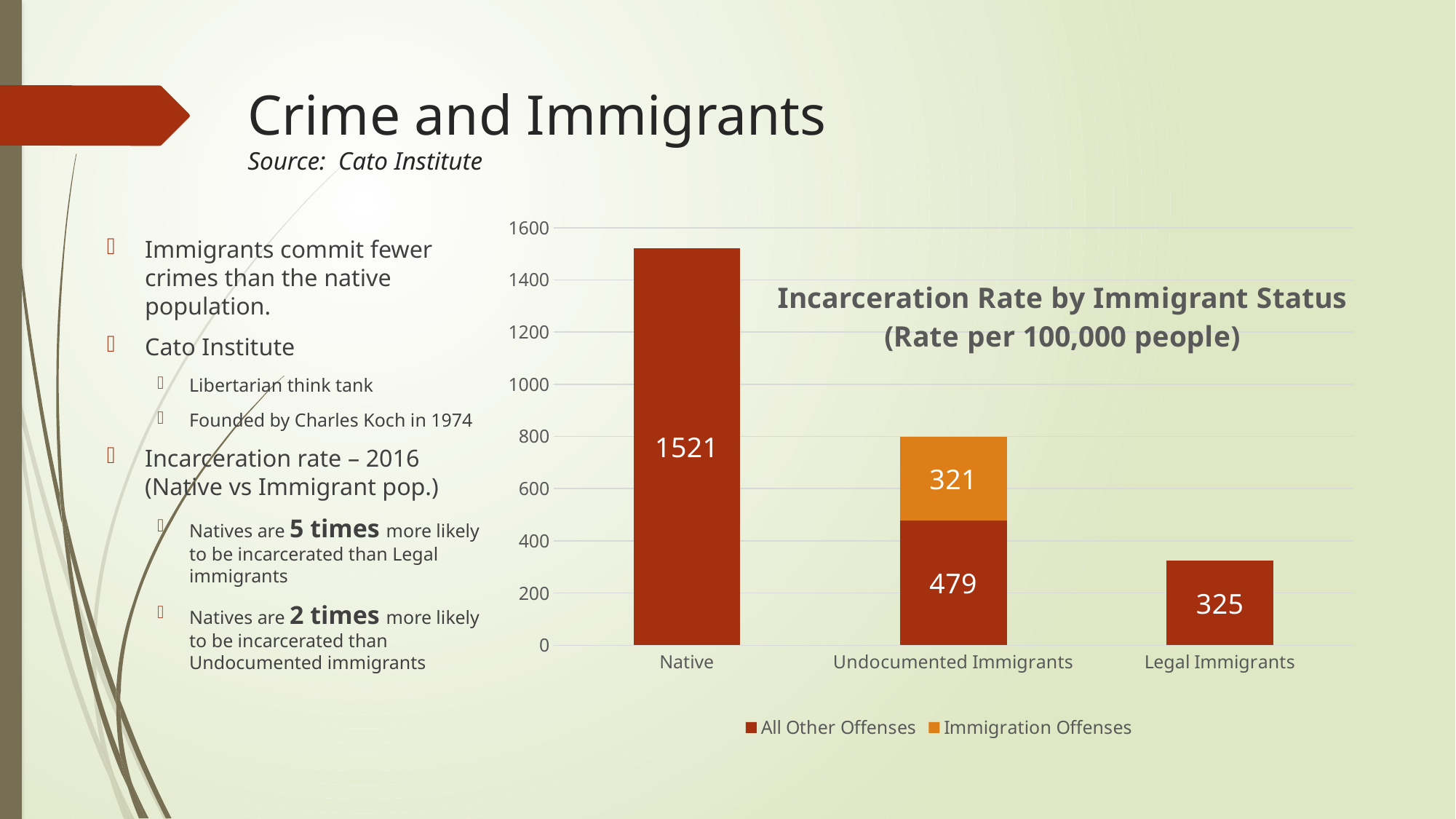
What is the All Other Offenses incarceration rate for Undocumented Immigrants? 479 Which category has the lowest total incarceration rate? Legal Immigrants What is the All Other Offenses incarceration rate for Native? 1521 Which category has the highest All Other Offenses incarceration rate? Native How many series does the legend list? 2 What is the difference between the All Other Offenses rate for Native and for Undocumented Immigrants? 1042 Which is larger: the All Other Offenses rate for Undocumented Immigrants or for Legal Immigrants? Undocumented Immigrants What is the total incarceration rate for Undocumented Immigrants (both offense types combined)? 800 How many categories are shown on the x axis? 3 What is the Immigration Offenses incarceration rate for Undocumented Immigrants? 321 What kind of chart is shown on the slide? Bar chart What is the All Other Offenses incarceration rate for Legal Immigrants? 325